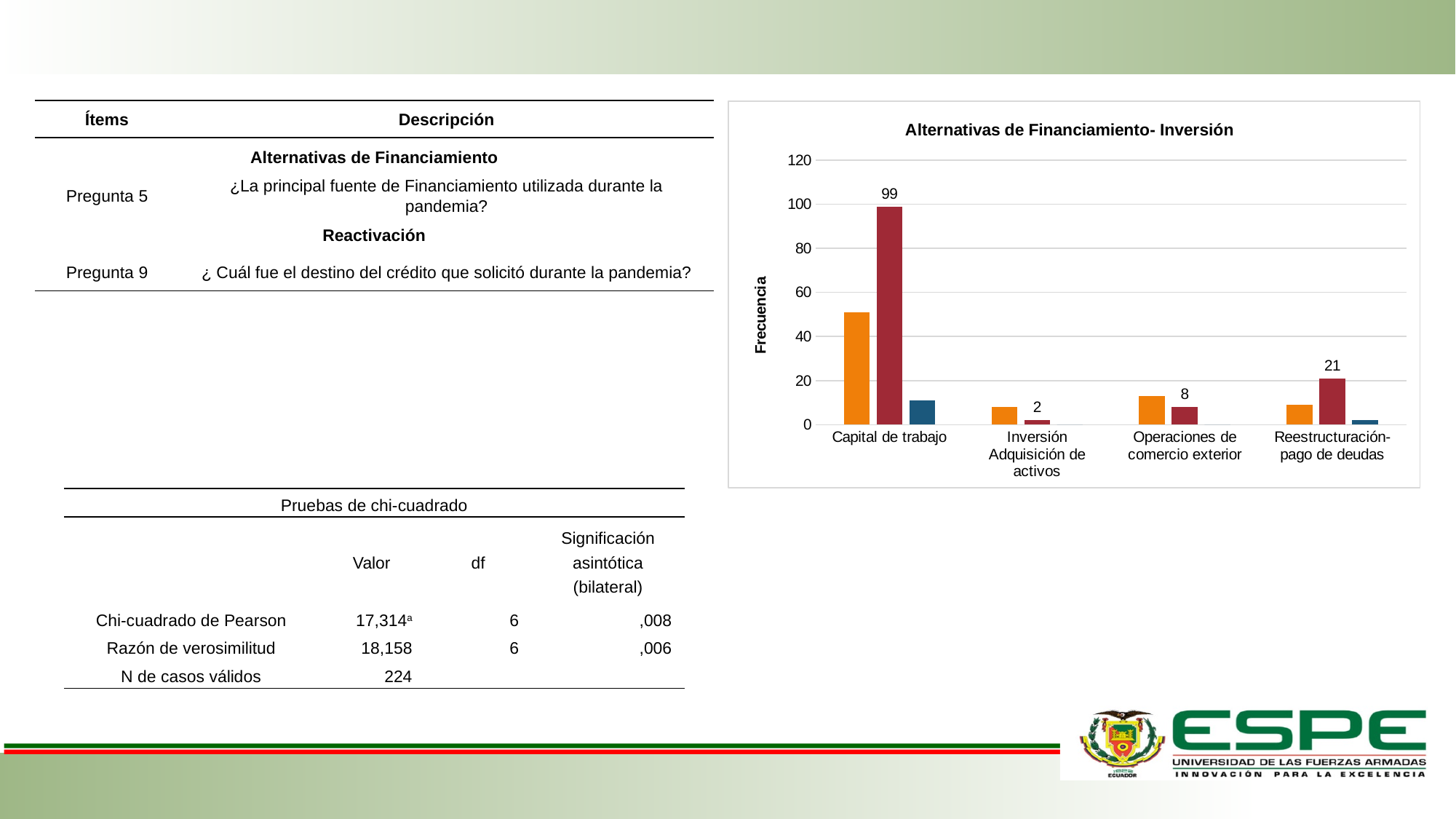
In the chart 'Alternativas de Financiamiento- Inversión', what is the value of the red bar for Reestructuración-pago de deudas? 21 In the chart 'Alternativas de Financiamiento- Inversión', is the value of the orange bar for Capital de trabajo greater or less than 40? greater In the chart 'Alternativas de Financiamiento- Inversión', which category has the highest red bar? Capital de trabajo In the chart 'Alternativas de Financiamiento- Inversión', what is the value of the red bar for Capital de trabajo? 99 In the chart 'Alternativas de Financiamiento- Inversión', what is the difference between the red bar values for Capital de trabajo and Reestructuración-pago de deudas? 78 How many categories are shown on the x axis of the chart 'Alternativas de Financiamiento- Inversión'? 4 In the chart 'Alternativas de Financiamiento- Inversión', what is the value of the red bar for Inversión Adquisición de activos? 2 What kind of chart is 'Alternativas de Financiamiento- Inversión'? bar chart In the chart 'Alternativas de Financiamiento- Inversión', which category has the lowest red bar? Inversión Adquisición de activos What is the label of the vertical axis in the chart 'Alternativas de Financiamiento- Inversión'? Frecuencia In the chart 'Alternativas de Financiamiento- Inversión', which has the larger red bar: Operaciones de comercio exterior or Reestructuración-pago de deudas? Reestructuración-pago de deudas In the chart 'Alternativas de Financiamiento- Inversión', what is the value of the red bar for Operaciones de comercio exterior? 8